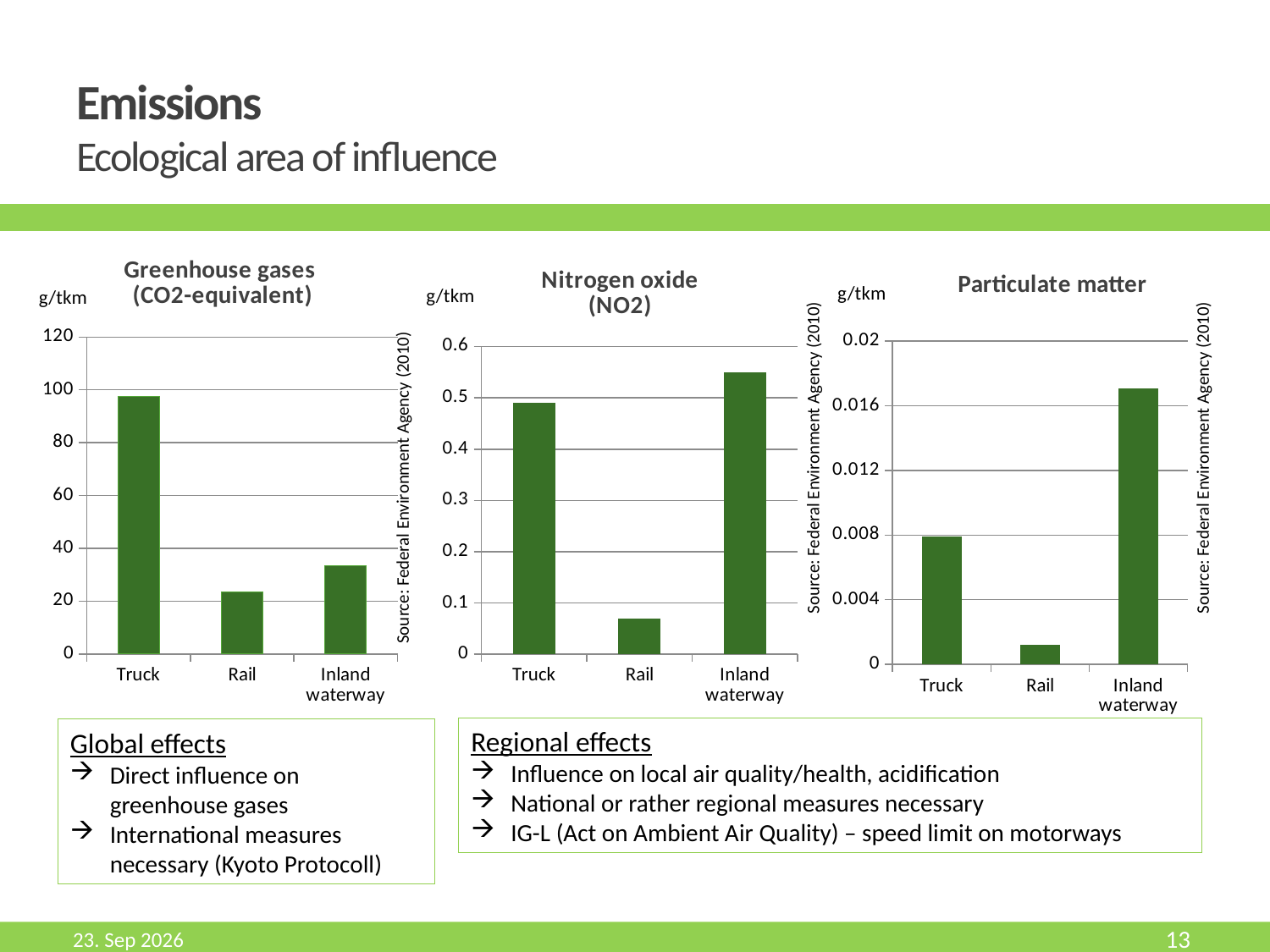
In the Greenhouse gases (CO2-equivalent) chart, which mode has the lowest emissions? Rail In the Particulate matter chart, is the value for Inland waterway greater or less than 0.012? greater How many transport modes are shown in the Particulate matter chart? 3 In the Nitrogen oxide (NO2) chart, is the value for Truck greater or less than 0.4? greater In the Nitrogen oxide (NO2) chart, is the value for Rail greater or less than 0.1? less In the Particulate matter chart, which is larger, the value for Truck or the value for Inland waterway? Inland waterway In the Greenhouse gases (CO2-equivalent) chart, which mode has the highest emissions? Truck In the Particulate matter chart, which mode has the lowest emissions? Rail What type of chart is the Nitrogen oxide (NO2) chart? Bar chart In the Nitrogen oxide (NO2) chart, which mode has the highest emissions? Inland waterway